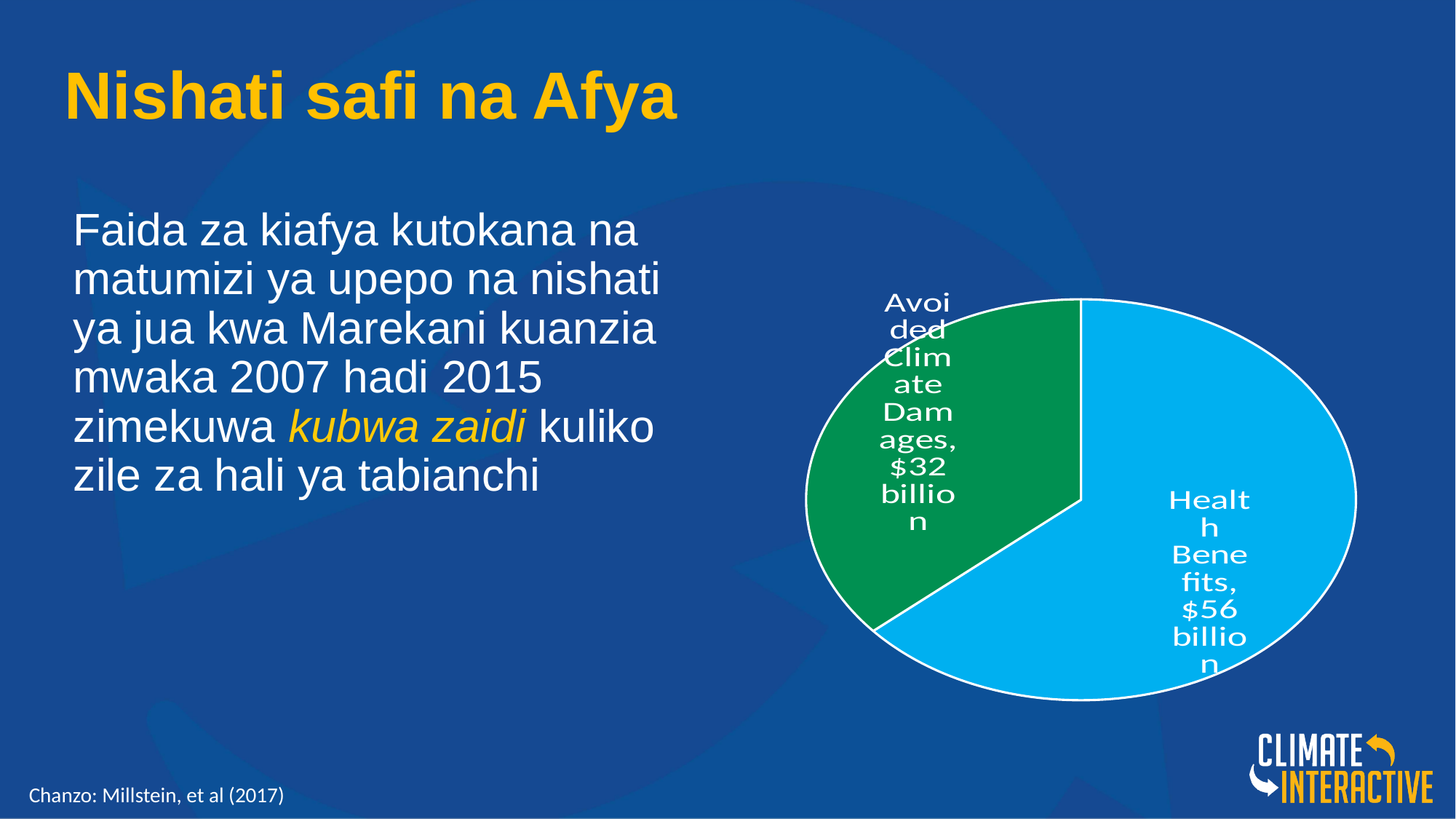
Which is larger in the pie chart: Health Benefits or Avoided Climate Damages? Health Benefits What is the difference between the Health Benefits value and the Avoided Climate Damages value in the pie chart? $24 billion Which slice of the pie chart is the smallest? Avoided Climate Damages Which slice of the pie chart is the largest? Health Benefits How many slices does the pie chart have? 2 What is the value of the Health Benefits slice in the pie chart? $56 billion What is the combined total of the two slices in the pie chart? $88 billion What colour is the Avoided Climate Damages slice in the pie chart? Green What share of the pie chart does the Health Benefits slice represent? 63.6% What kind of chart is shown on the slide? Pie chart What is the value of the Avoided Climate Damages slice in the pie chart? $32 billion What colour is the Health Benefits slice in the pie chart? Light blue